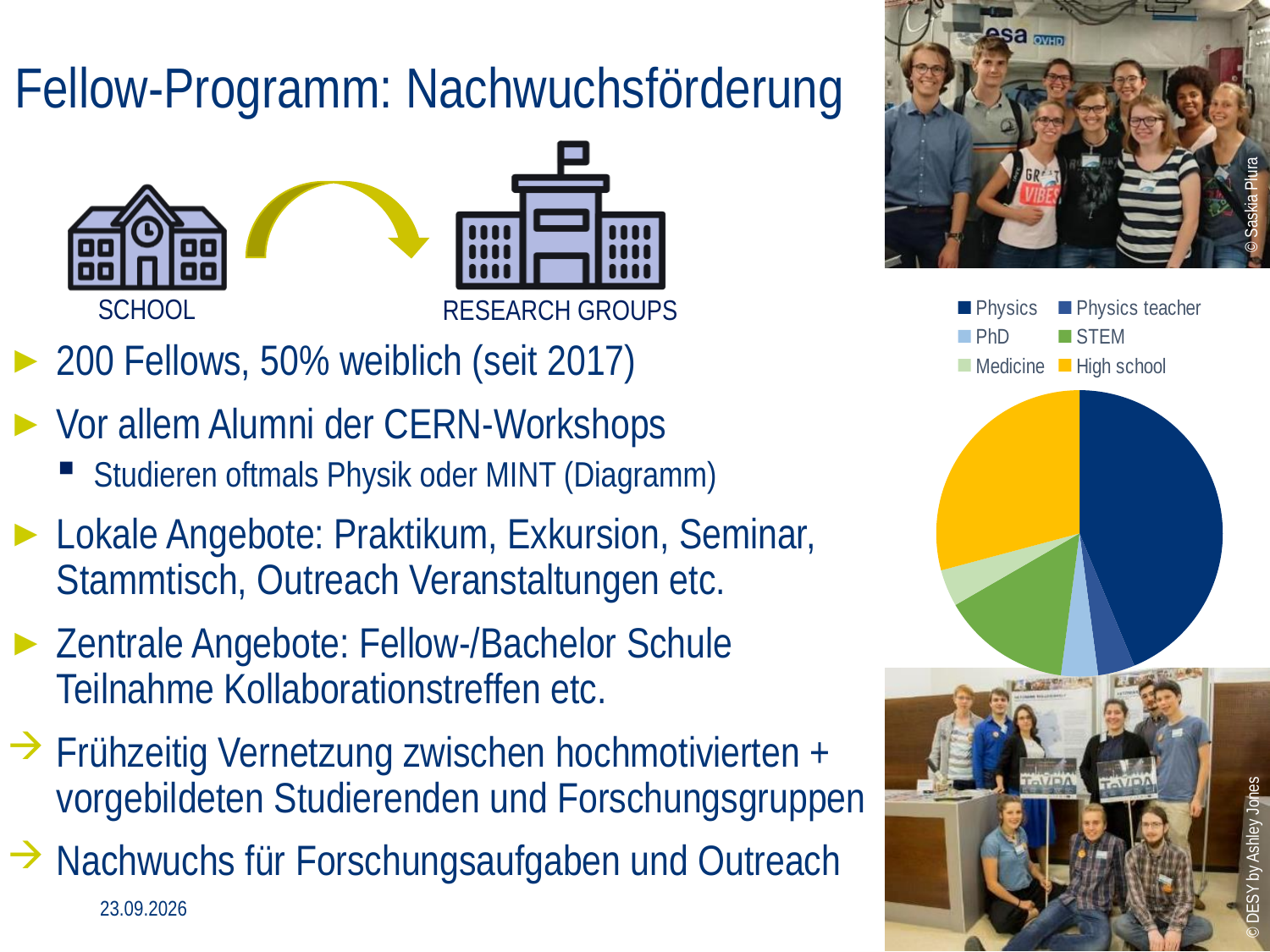
In the pie chart, which slice is larger: STEM or PhD? STEM Which category has the second-largest slice in the pie chart? High school What colour is the High school slice in the pie chart? yellow How many categories does the legend of the pie chart list? 6 Does the Physics slice take up more or less than half of the pie chart? less In the pie chart, which slice is larger: High school or STEM? High school What kind of chart is shown on the right side of the slide? pie chart What colour is the Physics slice in the pie chart? dark blue Which category has the largest slice in the pie chart? Physics In the pie chart, which slice is larger: Physics or STEM? Physics